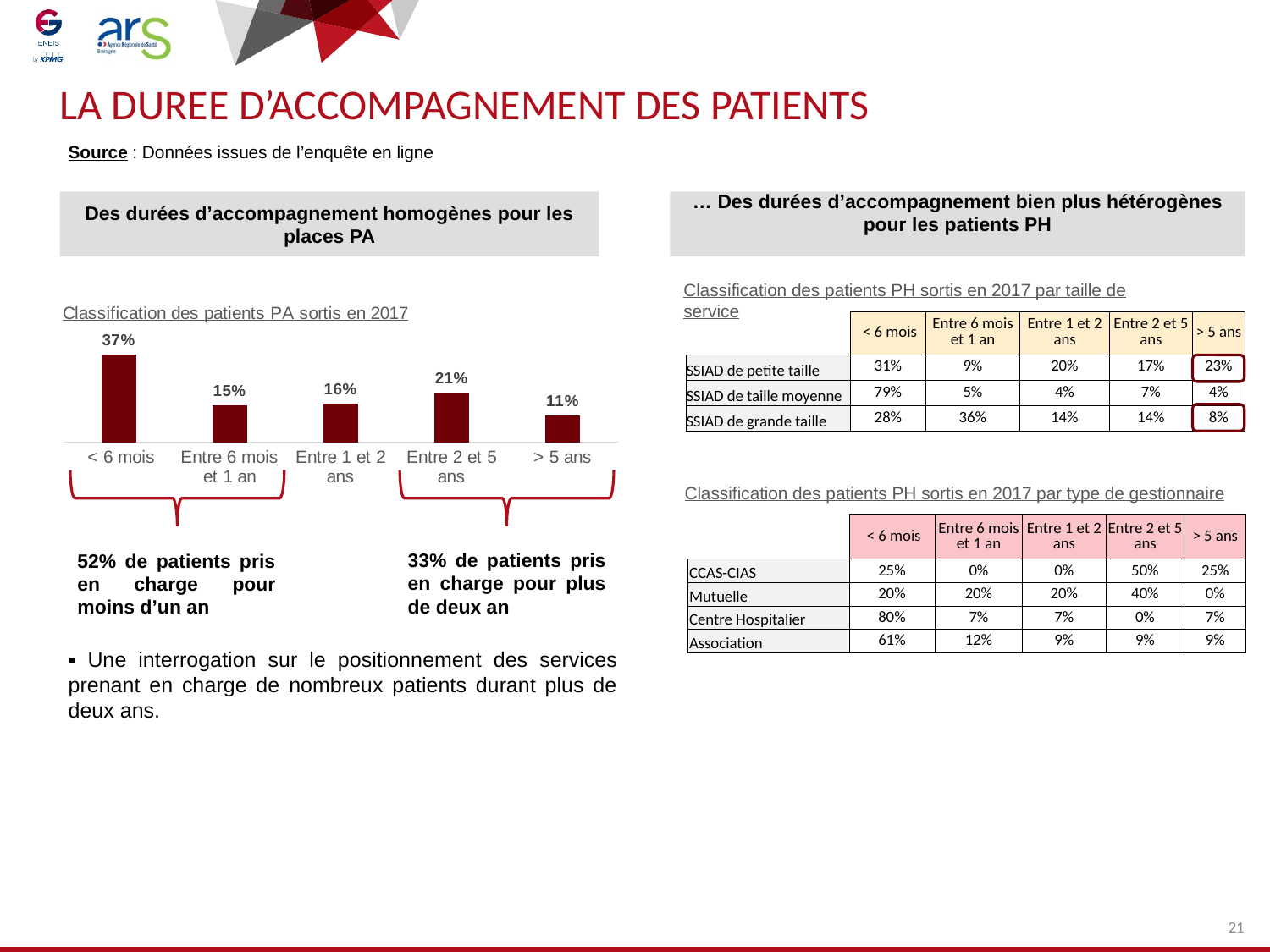
How many categories are shown in the chart 'Classification des patients PA sortis en 2017'? 5 What is the title of the bar chart on the left side of the slide? Classification des patients PA sortis en 2017 What kind of chart is 'Classification des patients PA sortis en 2017'? Bar chart In the chart 'Classification des patients PA sortis en 2017', what is the value for 'Entre 6 mois et 1 an'? 15% In the chart 'Classification des patients PA sortis en 2017', what is the difference between the values for 'Entre 2 et 5 ans' and 'Entre 1 et 2 ans'? 5% In the chart 'Classification des patients PA sortis en 2017', what is the difference between the values for '< 6 mois' and '> 5 ans'? 26% In the chart 'Classification des patients PA sortis en 2017', which category has the lowest value? > 5 ans In the chart 'Classification des patients PA sortis en 2017', which category has the highest value? < 6 mois In the chart 'Classification des patients PA sortis en 2017', what is the value for '> 5 ans'? 11% In the chart 'Classification des patients PA sortis en 2017', which is larger: the value for 'Entre 1 et 2 ans' or the value for 'Entre 6 mois et 1 an'? Entre 1 et 2 ans In the chart 'Classification des patients PA sortis en 2017', what is the value for 'Entre 2 et 5 ans'? 21% In the chart 'Classification des patients PA sortis en 2017', what is the value for '< 6 mois'? 37%